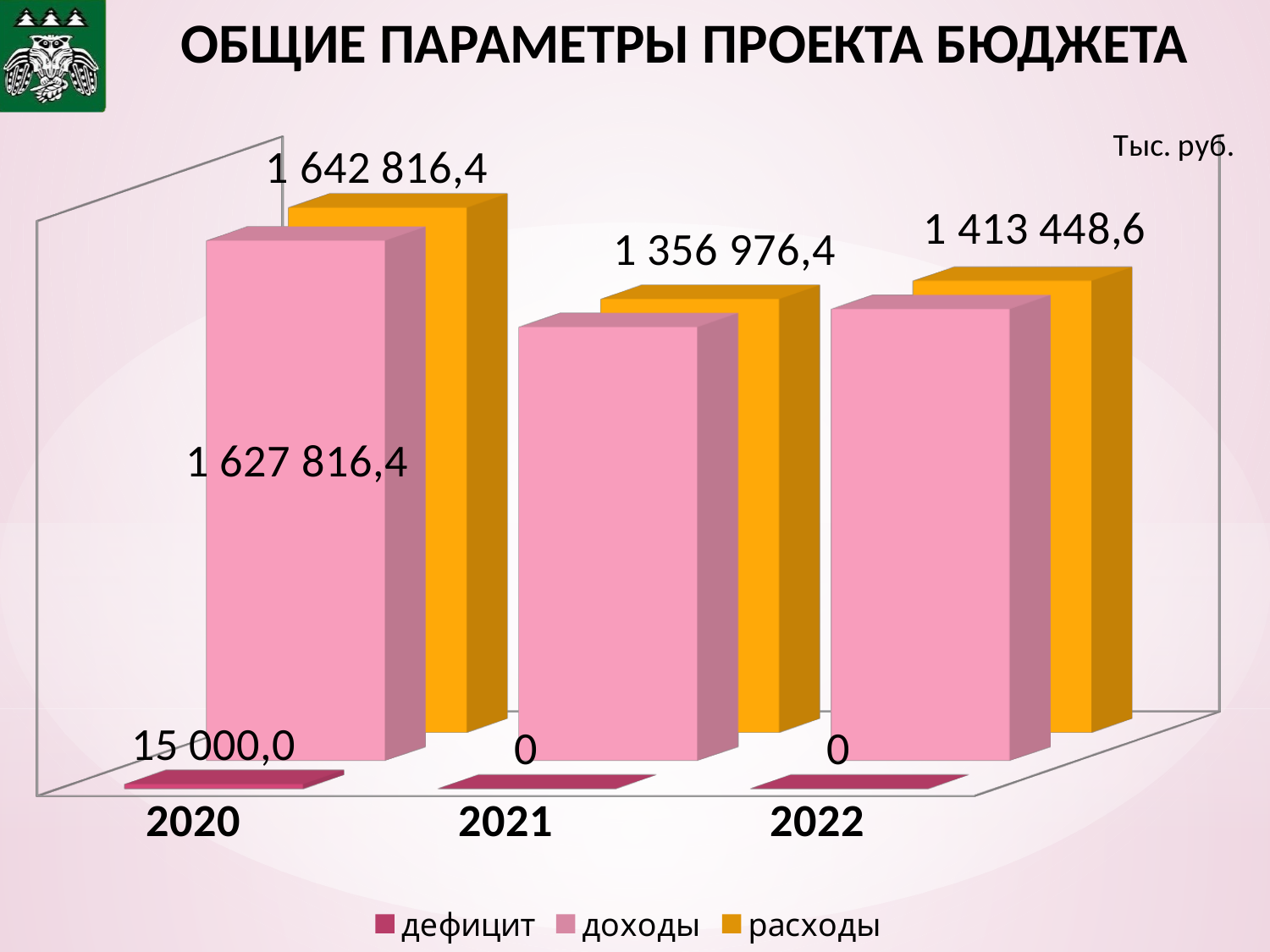
What is the value of дефицит for 2021? 0 What is the value of дефицит for 2020? 15 000,0 In which year is расходы the lowest? 2021 How many years are shown on the x axis? 3 What is the value of расходы for 2020? 1 642 816,4 In which year is расходы the highest? 2020 What is the difference between расходы and доходы in 2020? 15 000,0 What kind of chart is shown on the slide? Bar chart What is the value of расходы for 2021? 1 356 976,4 What is the value of расходы for 2022? 1 413 448,6 How many series does the legend list? 3 What is the value of доходы for 2020? 1 627 816,4